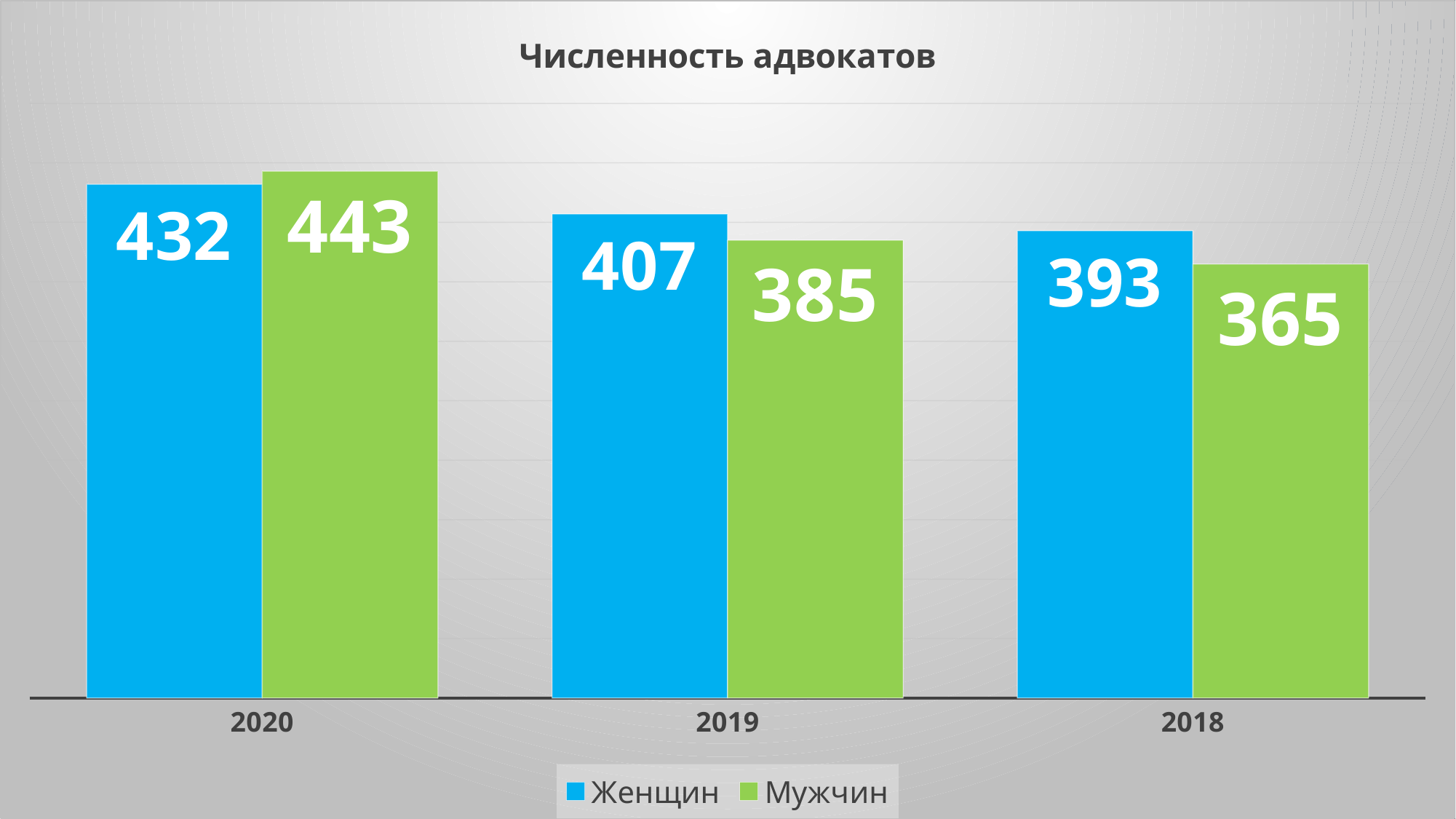
What is the title of the chart? Численность адвокатов What is the value for Мужчин in 2019? 385 What is the value for Женщин in 2020? 432 How many years are shown on the x axis? 3 What is the value for Мужчин in 2018? 365 What kind of chart is this? bar chart Which is larger in 2020, Женщин or Мужчин? Мужчин Which year has the lowest value for Женщин? 2018 What is the difference between Женщин and Мужчин in 2019? 22 Which year has the highest value for Мужчин? 2020 What is the difference between the Женщин values for 2020 and 2018? 39 How many series does the legend list? 2